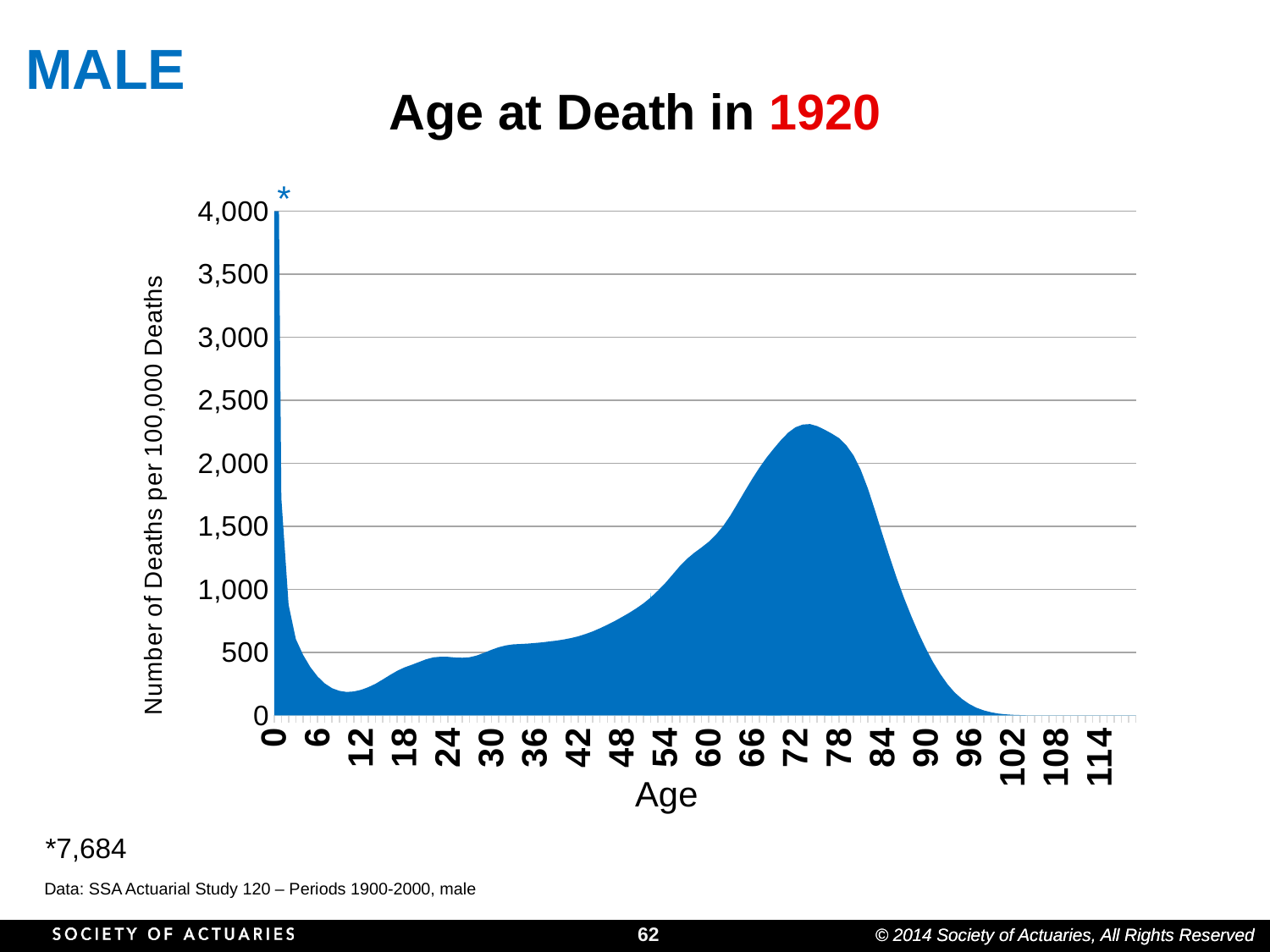
What is the label of the vertical axis? Number of Deaths per 100,000 Deaths According to the footnote, what is the number of deaths per 100,000 deaths at age 0? 7,684 What is the title of the chart? Age at Death in 1920 Is the value for age 72 greater or less than 2,000? greater Is the value for age 12 greater or less than 500? less Is the value for age 60 greater or less than 1,000? greater Which is larger, the value for age 6 or the value for age 12? Age 6 Between ages 78 and 102, do the values rise or fall as age increases? Fall Which age has the highest number of deaths per 100,000 deaths? 0 What kind of chart is shown on the slide? Area chart Which is larger, the value for age 72 or the value for age 24? Age 72